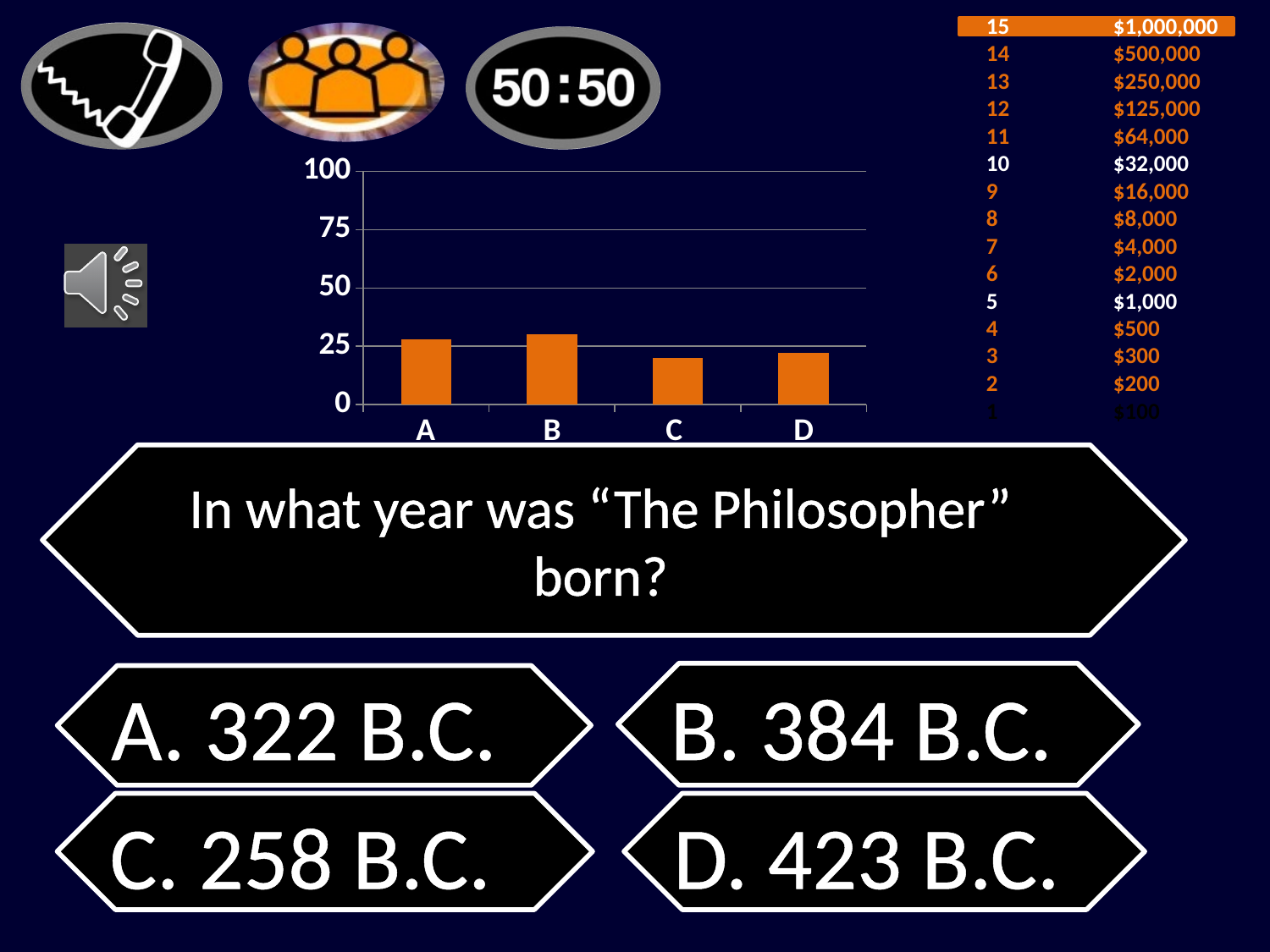
Which is larger, the value for B or the value for D? B How many categories are shown on the x axis of the bar chart? 4 Which is larger, the value for A or the value for C? A Which is larger, the value for B or the value for C? B What kind of chart is shown on the slide? bar chart What is the highest value shown on the y axis of the bar chart? 100 Is the value for B greater or less than 50? less Is the value for C greater or less than 25? less What colour are the bars in the chart? orange Is the value for A greater or less than 50? less